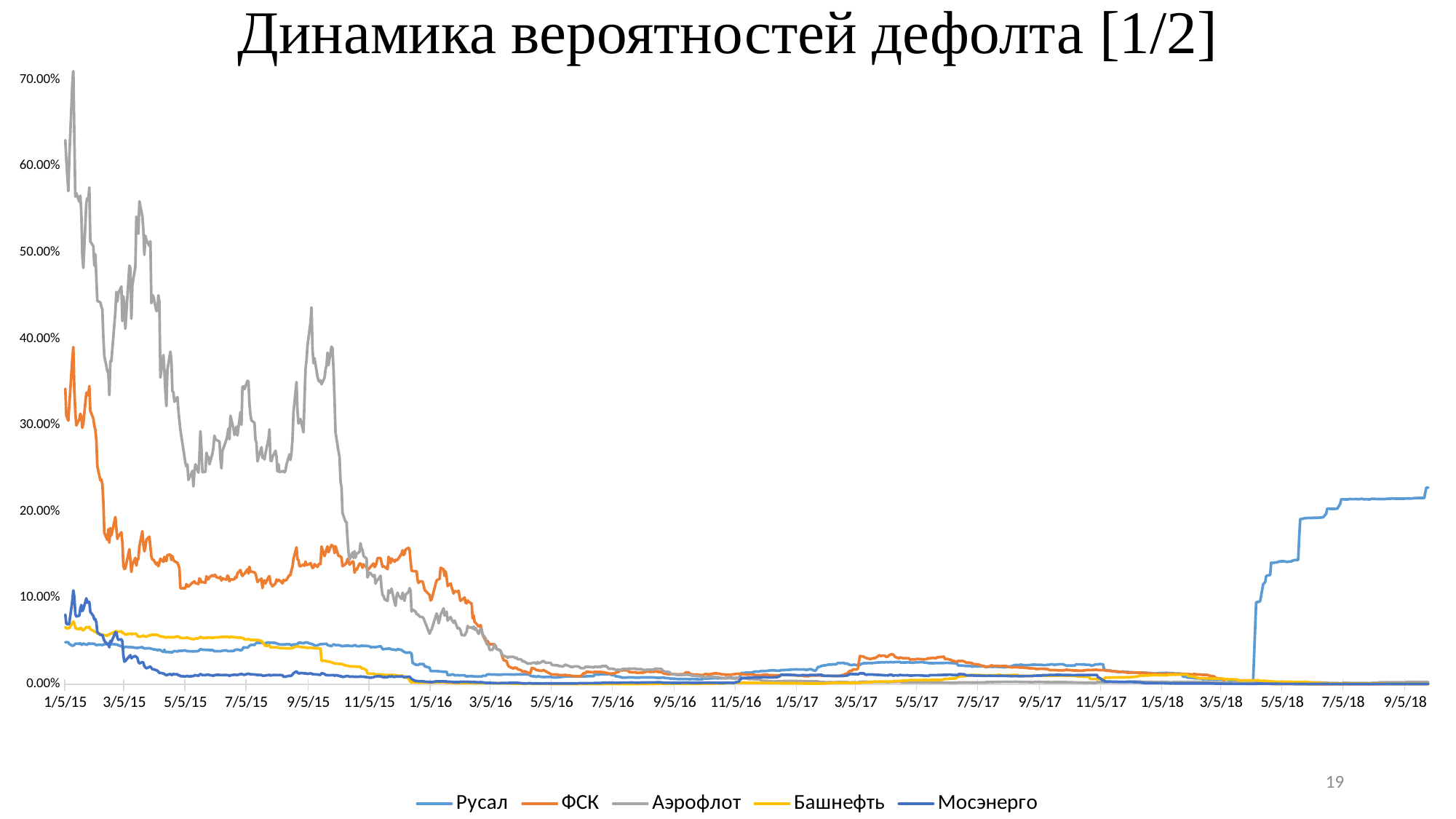
Does the Аэрофлот series rise or fall between 1/5/15 and 5/5/16? fall What is the title of the chart? Динамика вероятностей дефолта [1/2] At 9/5/18, which series has the larger value, Русал or ФСК? Русал What kind of chart is shown on the slide? line chart Is the value for Мосэнерго at 5/5/15 greater or less than 5.00%? less How many series does the legend list? 5 At 1/5/15, which series has the larger value, Аэрофлот or ФСК? Аэрофлот Which series reaches the highest value on the chart? Аэрофлот Is the value for Аэрофлот at 1/5/15 greater or less than 50.00%? greater Is the value for ФСК at 1/5/15 greater or less than 30.00%? greater Does the Русал series rise or fall between 3/5/18 and 9/5/18? rise